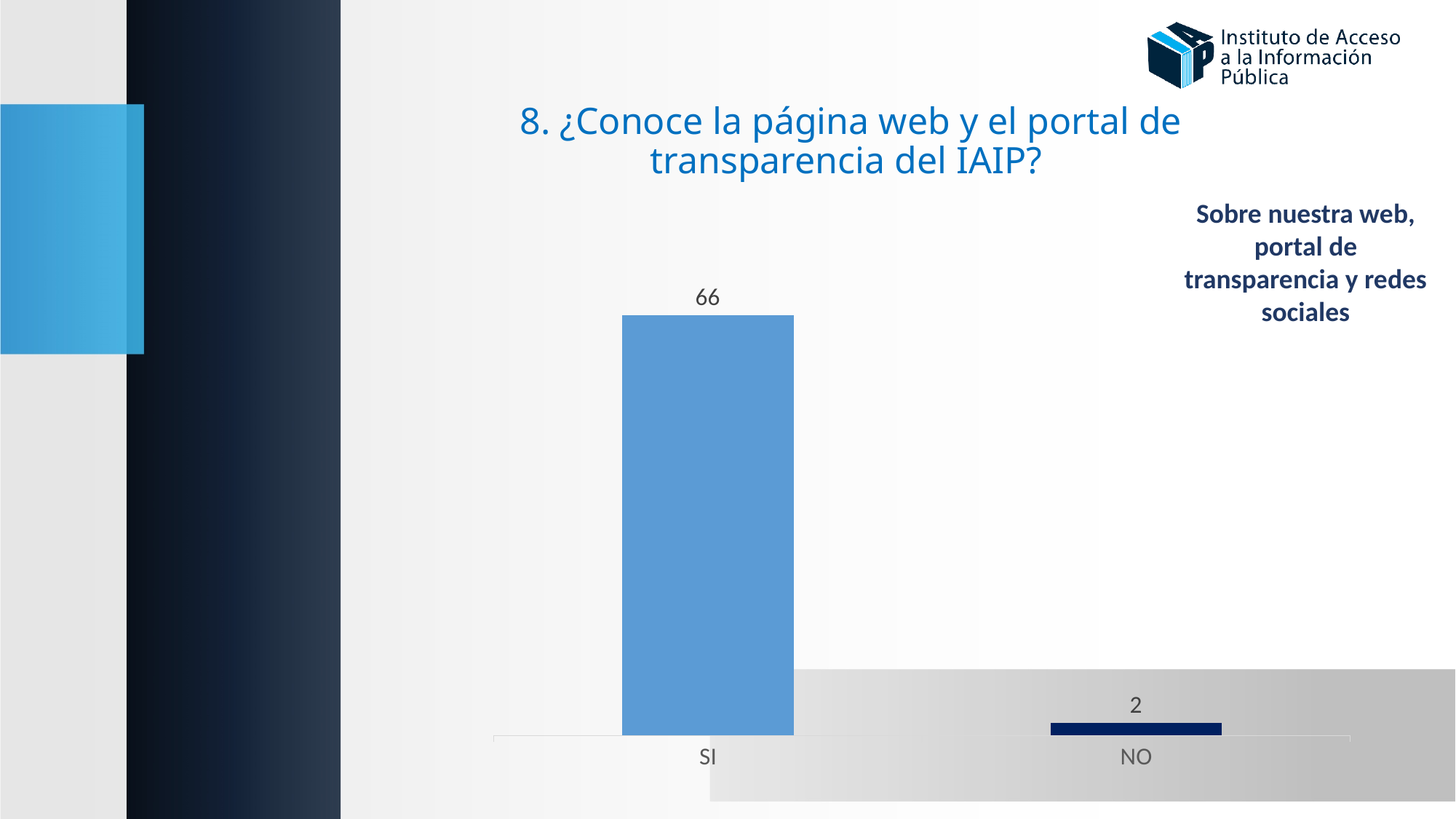
What is the title of the slide above the chart? 8. ¿Conoce la página web y el portal de transparencia del IAIP? What is the value for SI? 66 What is the difference between the values for SI and NO? 64 What is the value for NO? 2 Which is larger, the value for SI or the value for NO? SI Which category has the highest value? SI What colour is the bar for NO? Dark blue What kind of chart is shown on the slide? Bar chart How many categories are shown in the chart? 2 Which category has the lowest value? NO What is the total of the values for SI and NO? 68